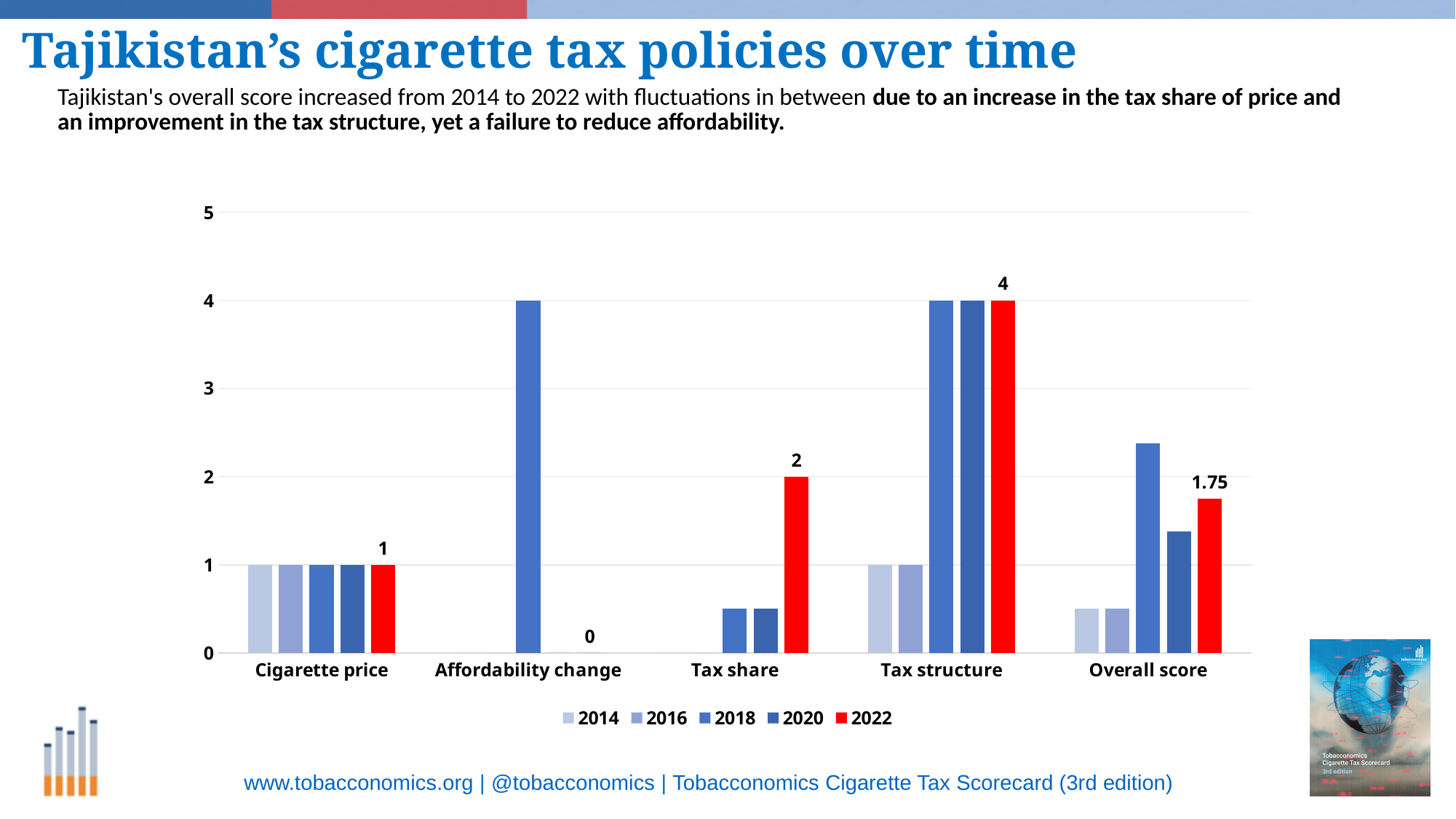
Which is larger in 2022: Tax share or Overall score? Tax share Among the 2022 bars, which category has the highest value? Tax structure What is the 2022 value for Affordability change? 0 What is the 2022 value for Overall score? 1.75 How many categories are shown on the x axis? 5 Among the 2022 bars, which category has the lowest value? Affordability change What is the 2022 value for Tax share? 2 How many series does the legend list? 5 What is the difference between the 2022 values for Tax structure and Tax share? 2 What is the 2022 value for Tax structure? 4 What is the 2022 value for Cigarette price? 1 Is the 2018 value for Overall score greater or less than 2? greater